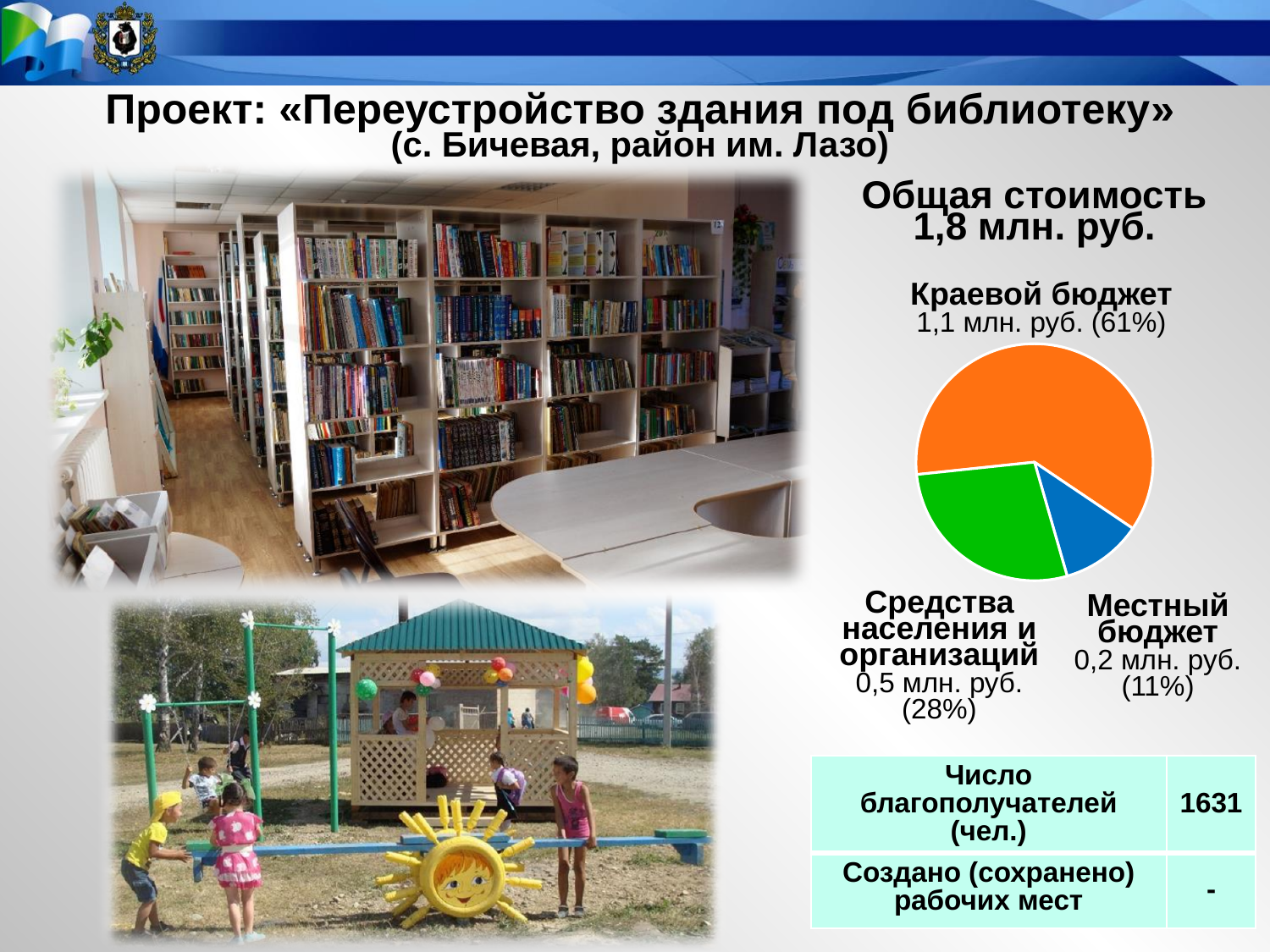
What is the value for Средства населения и организаций in the pie chart? 0,5 млн. руб. What is the difference between the Краевой бюджет and Местный бюджет values in the pie chart? 0,9 млн. руб. Which source has the largest slice in the pie chart? Краевой бюджет What kind of chart is shown on the slide? pie chart What is the value for Краевой бюджет in the pie chart? 1,1 млн. руб. Which source has the smallest slice in the pie chart? Местный бюджет What share of the pie does Краевой бюджет represent? 61% Which is larger in the pie chart: Средства населения и организаций or Местный бюджет? Средства населения и организаций What is the value for Местный бюджет in the pie chart? 0,2 млн. руб. What share of the pie does Средства населения и организаций represent? 28% What share of the pie does Местный бюджет represent? 11% How many slices does the pie chart have? 3